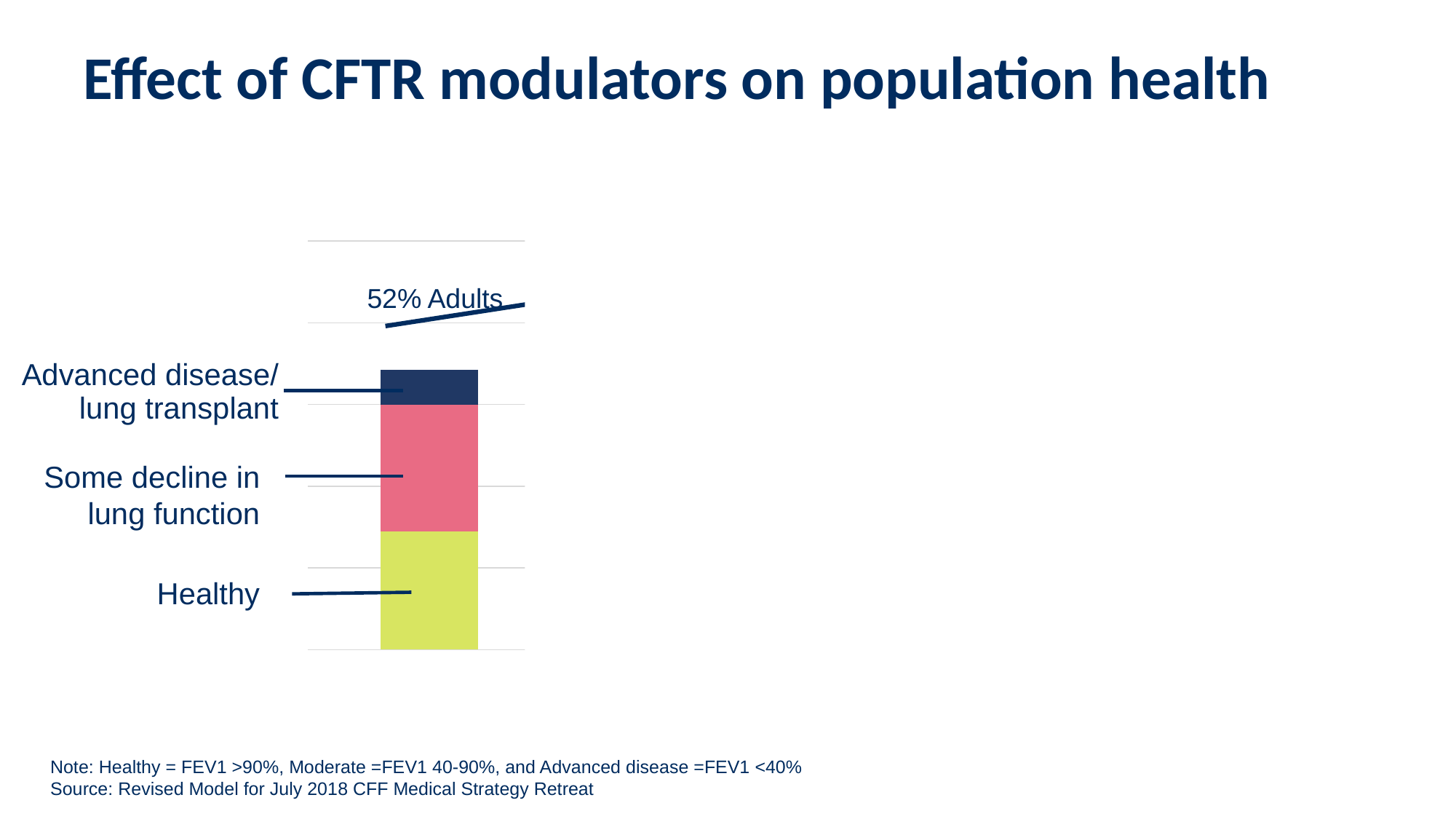
What annotation label is shown above the stacked bar? 52% Adults Which segment of the stacked bar is the smallest? Advanced disease/lung transplant Which segment is larger: Some decline in lung function or Advanced disease/lung transplant? Some decline in lung function What kind of chart is shown on the slide? Stacked bar chart Which segment is at the bottom of the stacked bar? Healthy Which segment is at the top of the stacked bar? Advanced disease/lung transplant Which segment is larger: Healthy or Advanced disease/lung transplant? Healthy How many segments make up the stacked bar? 3